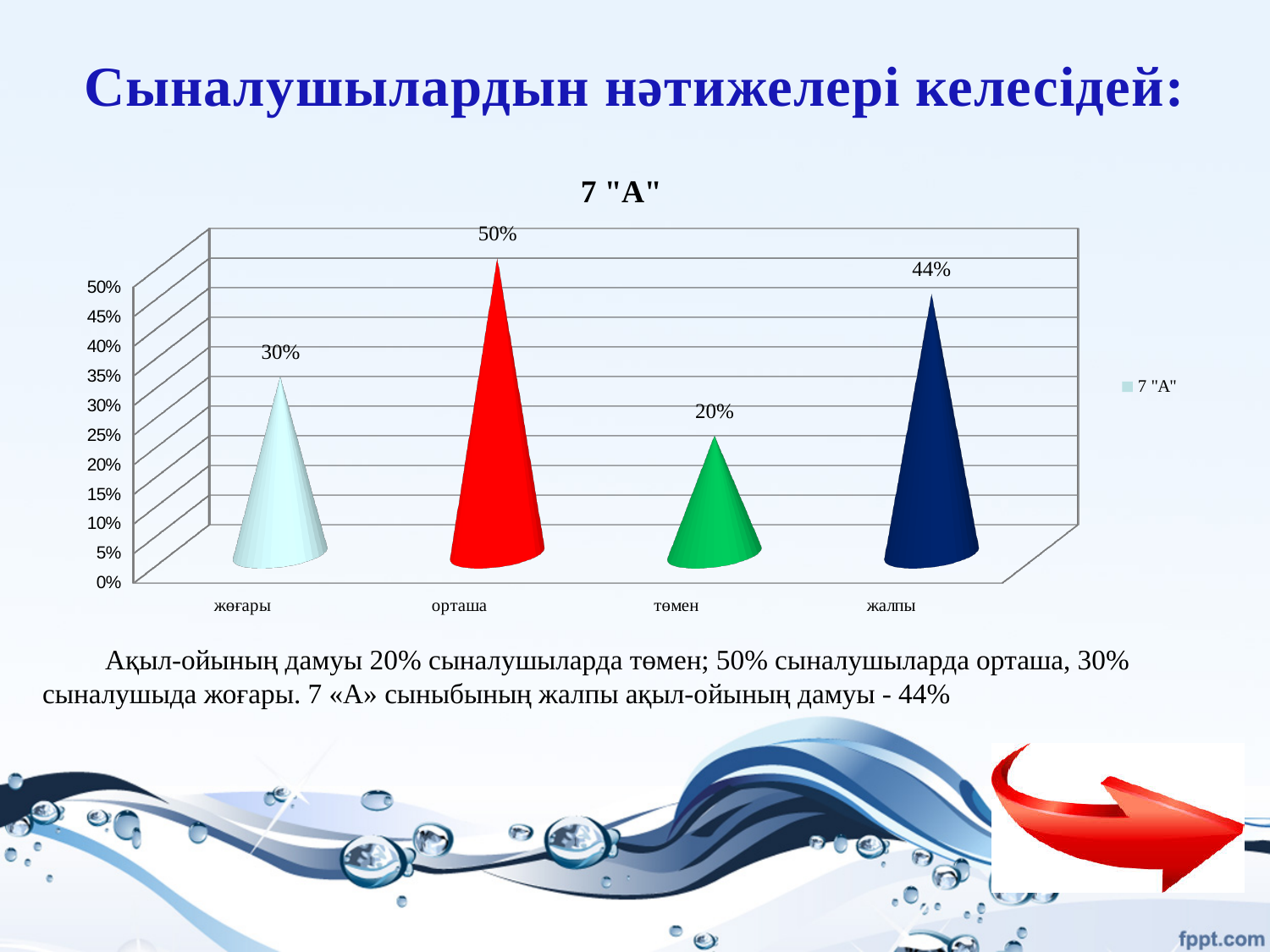
What is the title of the chart? 7 "А" What is the value for жоғары? 30% Which category has the highest value? орташа How many categories are shown on the x axis? 4 What is the value for жалпы? 44% What is the difference between the values for орташа and төмен? 30% What is the difference between the values for жалпы and жоғары? 14% Which category has the lowest value? төмен What is the value for төмен? 20% What is the value for орташа? 50% What kind of chart is shown on the slide? bar chart Which is larger, the value for жоғары or the value for жалпы? жалпы